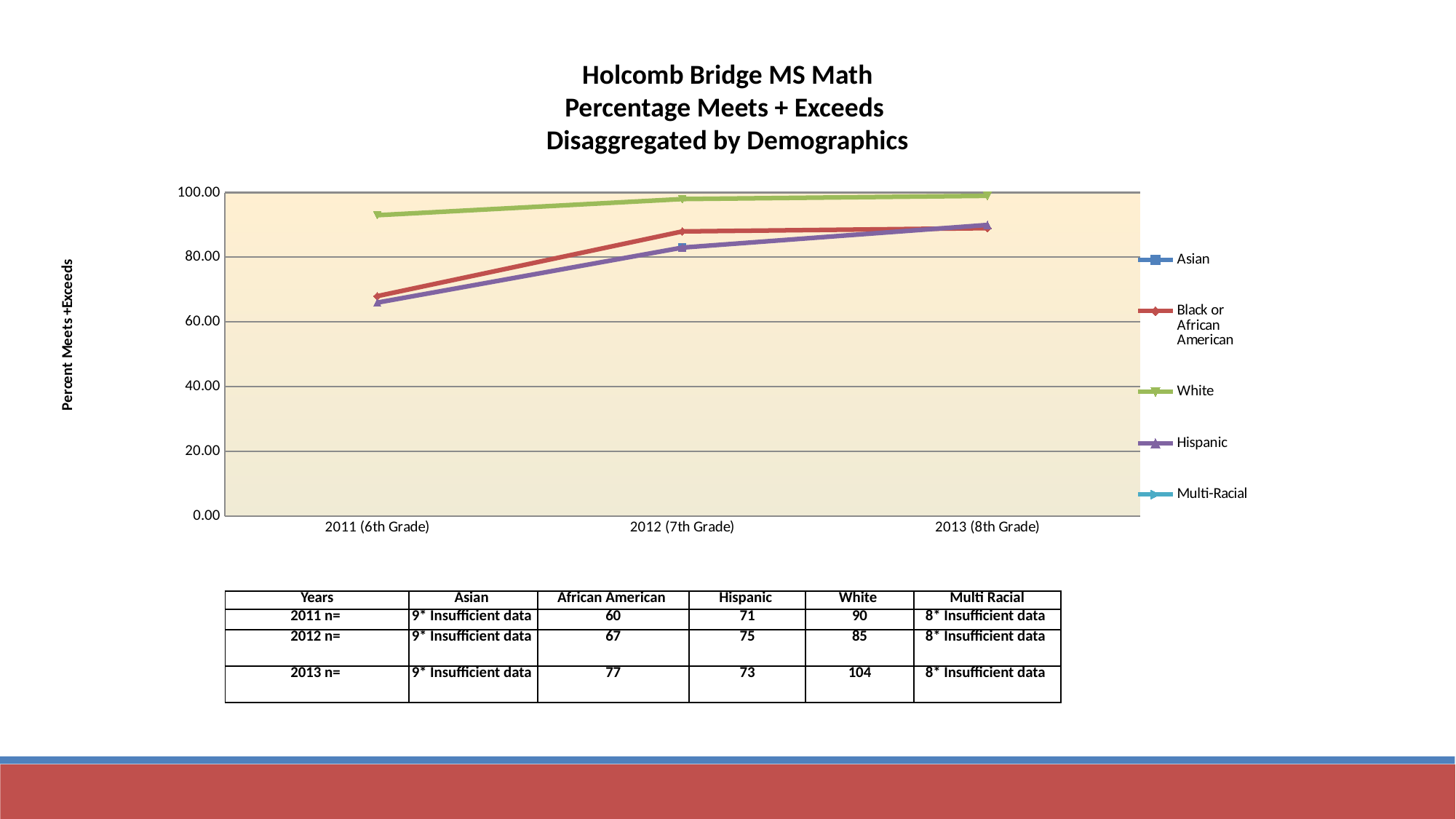
How many points are there along the x axis of the chart? 3 Is the value for Hispanic in 2013 (8th Grade) greater or less than 80.00? greater Which series has the highest value in 2011 (6th Grade)? White Does the Hispanic line rise or fall from 2011 (6th Grade) to 2013 (8th Grade)? rise Is the value for Black or African American in 2011 (6th Grade) greater or less than 80.00? less In 2012 (7th Grade), which is larger: the value for Black or African American or the value for Hispanic? Black or African American How many series does the chart legend list? 5 What kind of chart is shown on the slide? line chart Is the value for White in 2011 (6th Grade) greater or less than 80.00? greater In 2012 (7th Grade), which is larger: the value for White or the value for Black or African American? White What is the label on the y axis of the chart? Percent Meets +Exceeds